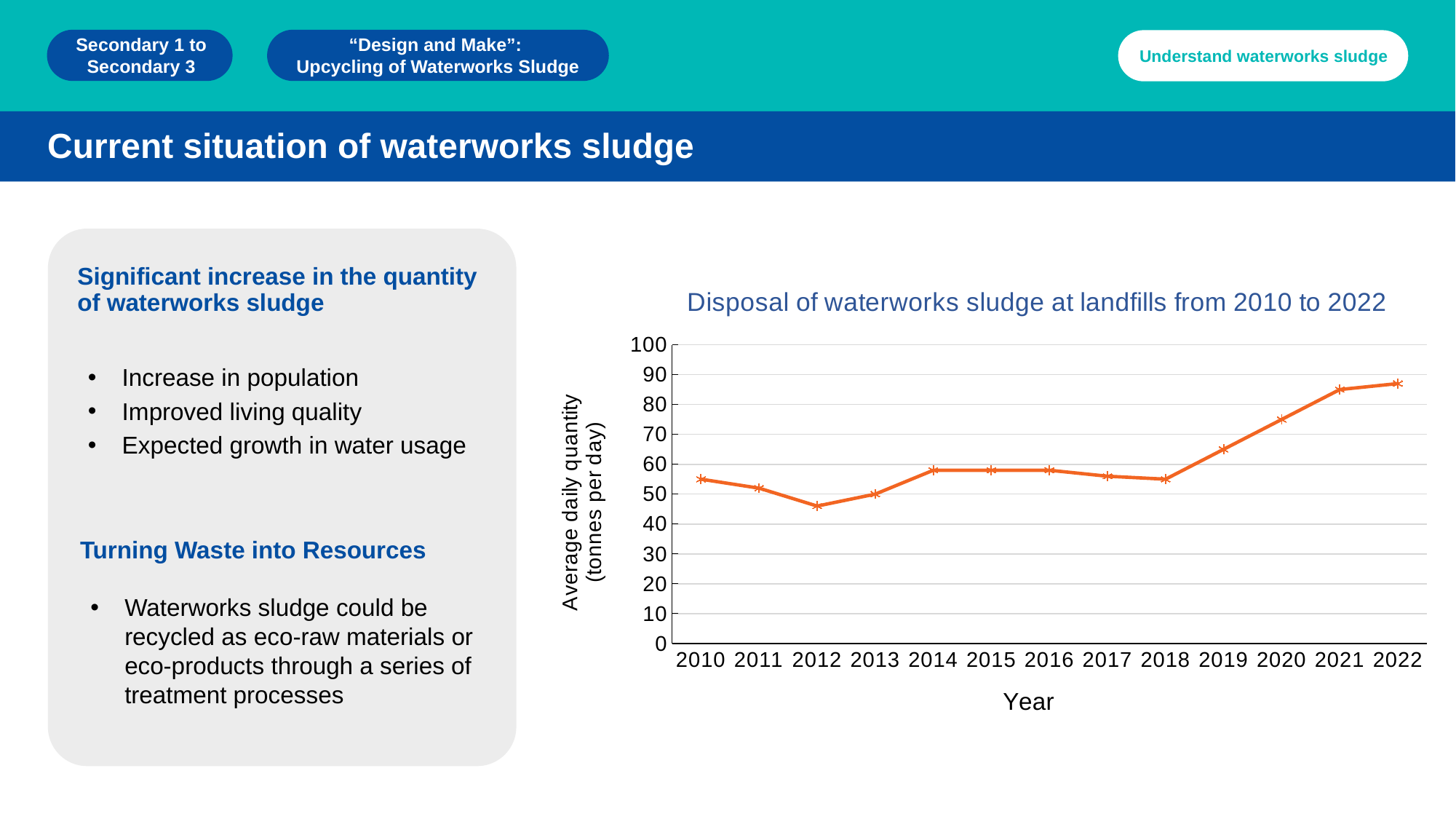
Do the values rise or fall from 2018 to 2022? Rise Which year has the highest average daily quantity of waterworks sludge disposed at landfills? 2022 What is the label of the vertical axis of the chart? Average daily quantity (tonnes per day) Is the value for 2012 greater or less than 50? less Which year has the lowest average daily quantity of waterworks sludge disposed at landfills? 2012 Is the value for 2022 greater or less than 90? less What type of chart is shown on the slide? Line chart Is the value for 2021 greater or less than 80? greater What is the title of the chart? Disposal of waterworks sludge at landfills from 2010 to 2022 Which year has a larger value, 2014 or 2020? 2020 How many years are plotted on the chart? 13